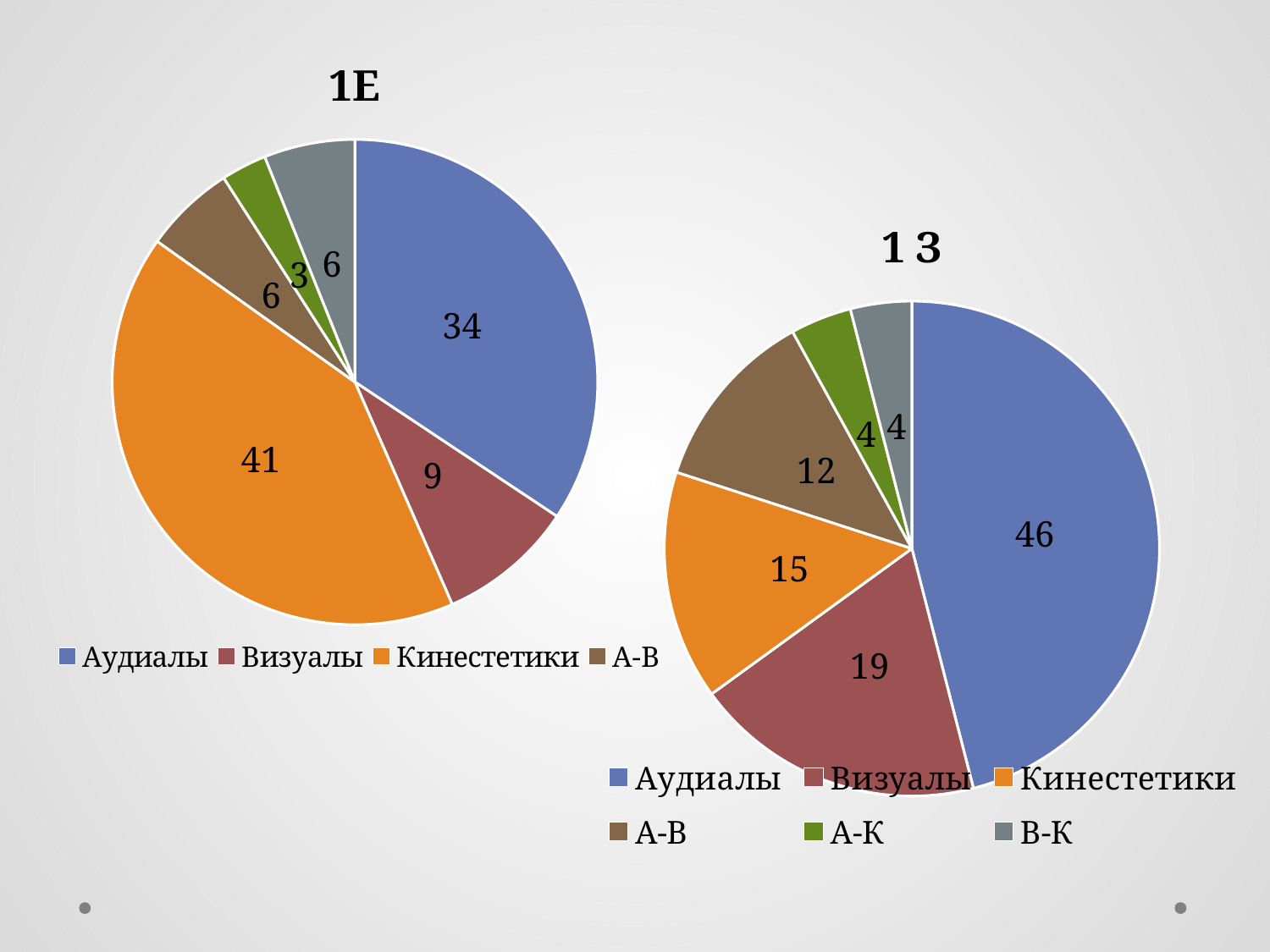
In the chart titled 1Е, what is the value for Аудиалы? 34 In the chart titled 1 З, how many slices does the pie have? 6 How many entries does the legend of the chart titled 1 З list? 6 In the chart titled 1 З, what is the value for А-В? 12 In the chart titled 1 З, which category has the largest slice? Аудиалы What kind of chart is the chart titled 1 З? Pie chart In the chart titled 1 З, what share of the total does Аудиалы represent? 46% In the chart titled 1Е, what is the value for Кинестетики? 41 In the chart titled 1 З, what is the value for Визуалы? 19 In the chart titled 1Е, which category has the largest slice? Кинестетики In the chart titled 1 З, what is the difference between the values for Аудиалы and Визуалы? 27 In the chart titled 1Е, which is larger, Визуалы or А-В? Визуалы